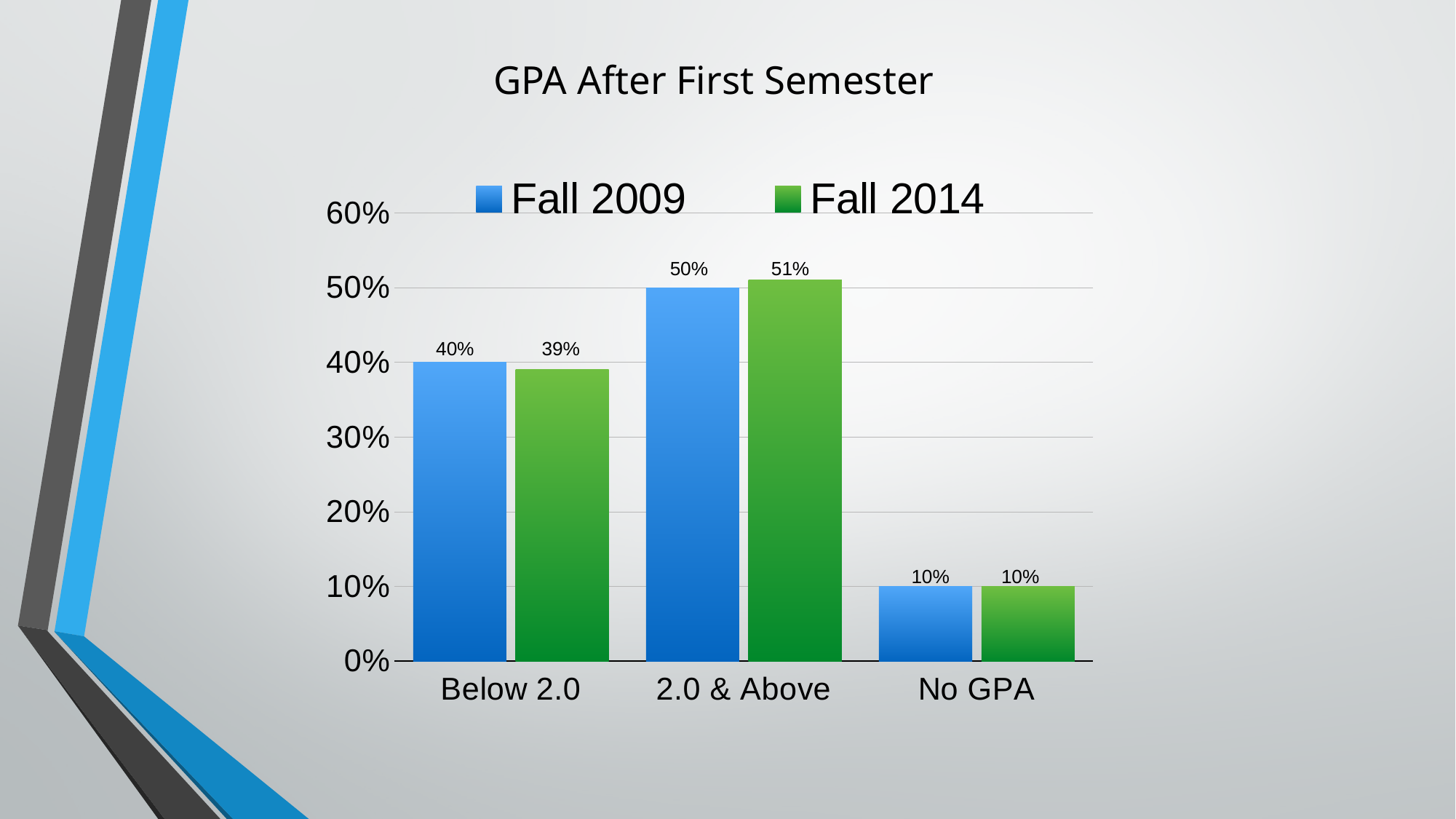
What is the Fall 2009 value for Below 2.0? 40% Which category has the highest Fall 2009 value? 2.0 & Above What is the title of the chart? GPA After First Semester What is the Fall 2014 value for No GPA? 10% What kind of chart is shown on the slide? bar chart Is the Fall 2009 value for 2.0 & Above greater or less than 30%? greater What is the difference between the Fall 2009 and Fall 2014 values for Below 2.0? 1% Which category has the lowest Fall 2014 value? No GPA What is the Fall 2014 value for 2.0 & Above? 51% Which is larger for 2.0 & Above: Fall 2009 or Fall 2014? Fall 2014 How many categories are shown on the x axis? 3 How many series does the legend list? 2